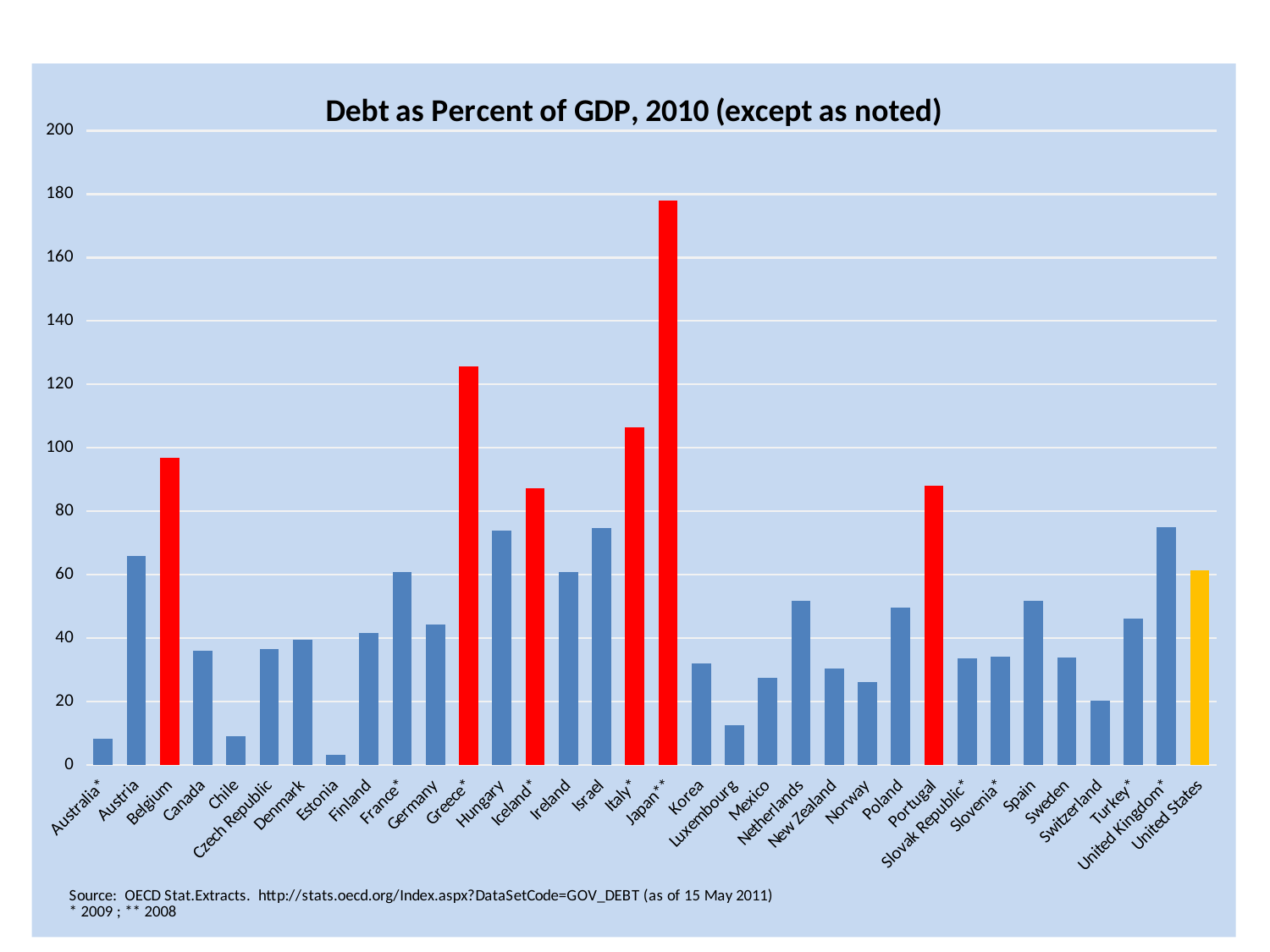
What colour is the bar for United States? yellow Which country has the lowest debt as percent of GDP in the chart? Estonia What kind of chart is shown on the slide? bar chart Is the value for Japan** greater or less than 160? greater Is the value for Belgium greater or less than 100? less Which has a higher debt as percent of GDP, Austria or Canada? Austria Which has a higher debt as percent of GDP, Greece* or Italy*? Greece* How many countries are shown on the x axis of the chart? 34 Is the value for Greece* greater or less than 120? greater What is the title of the chart? Debt as Percent of GDP, 2010 (except as noted) Which country has the highest debt as percent of GDP in the chart? Japan**